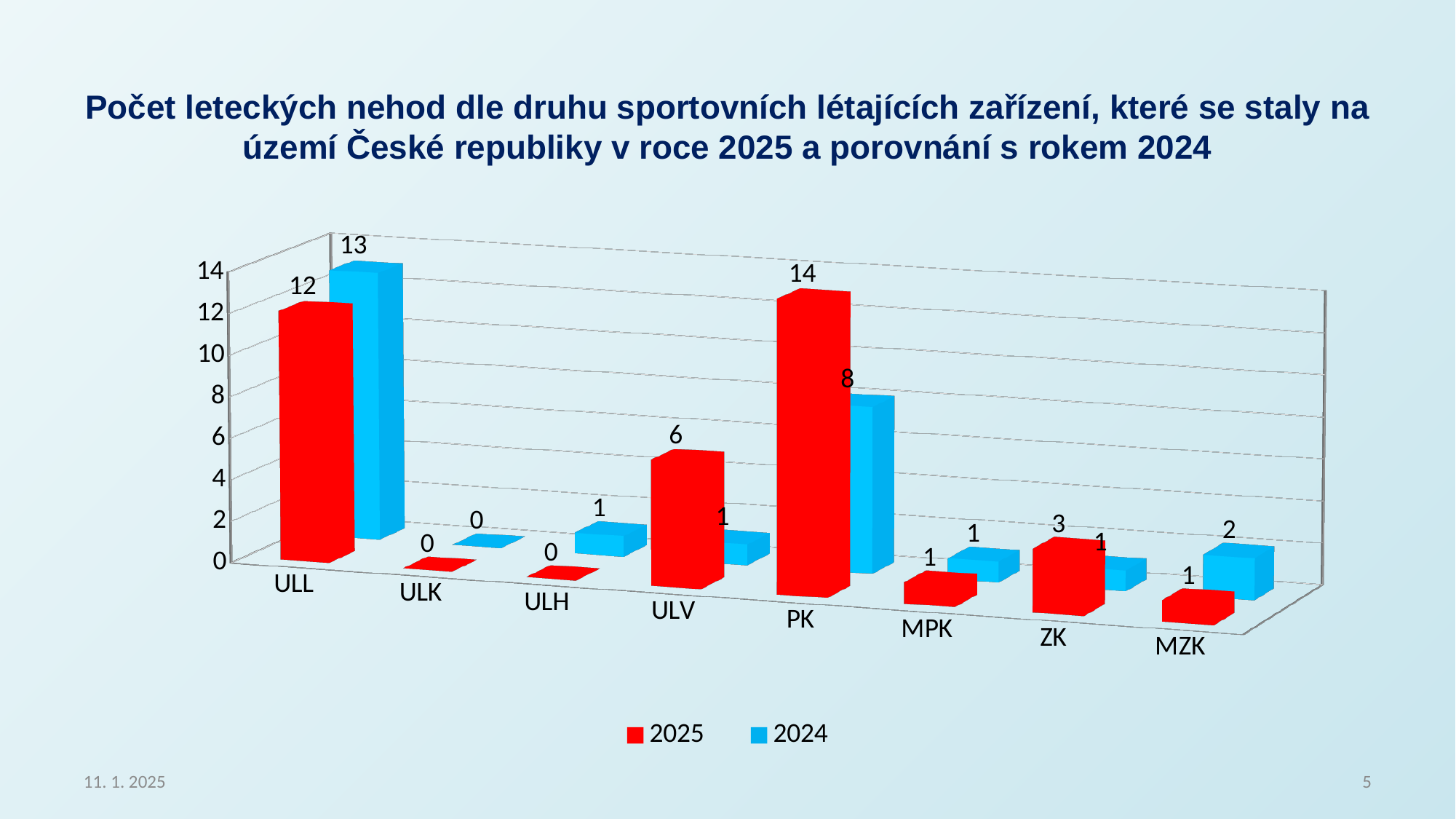
Which category has the highest value in the 2025 series? PK What is the value for MZK in the 2024 series? 2 What is the value for PK in the 2025 series? 14 Which colour represents the 2025 series? red How many series does the legend list? 2 What is the difference between the 2025 and 2024 values for PK? 6 What is the value for ULV in the 2025 series? 6 What kind of chart is shown on the slide? bar chart Which category has the highest value in the 2024 series? ULL What is the value for ULL in the 2024 series? 13 How many categories are shown on the x axis? 8 Which is larger for ULL: the 2025 value or the 2024 value? 2024